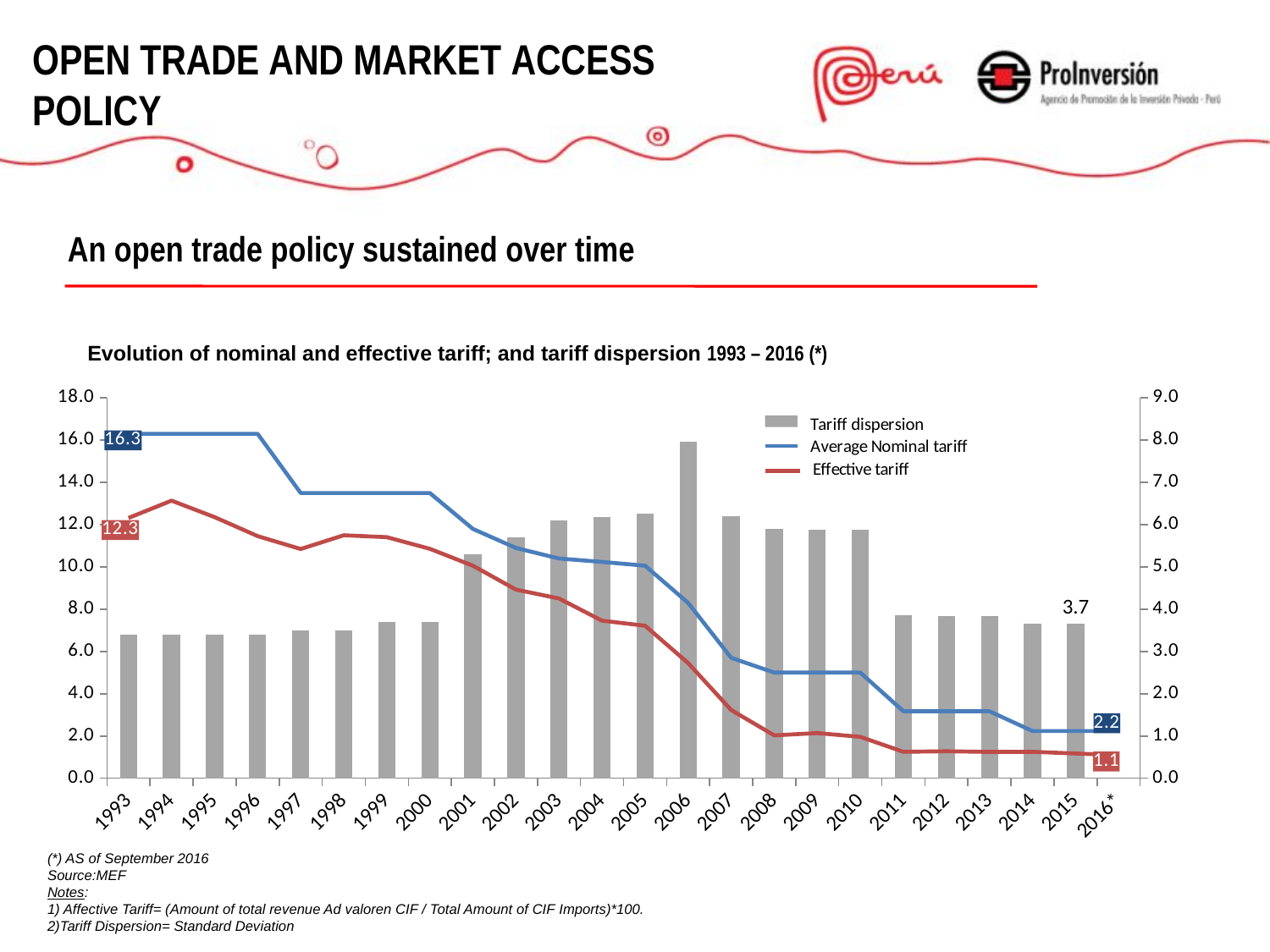
What is the value labeled for the Average Nominal tariff in 1993? 16.3 How many series does the legend list? 3 What is the value labeled for the Effective tariff in 2016*? 1.1 Is the Tariff dispersion bar for 2006 greater or less than 14.0 on the left axis? greater Does the Average Nominal tariff rise or fall from 1993 to 2016*? fall How many years are shown on the x axis? 24 What is the value labeled for the Effective tariff in 1993? 12.3 By how much did the Average Nominal tariff fall from 1993 to 2016*? 14.1 In which year is the Tariff dispersion bar the tallest? 2006 What is the value labeled for the Average Nominal tariff in 2016*? 2.2 Which is larger in 2016*, the Average Nominal tariff or the Effective tariff? Average Nominal tariff What is the difference between the Average Nominal tariff and the Effective tariff in 1993? 4.0